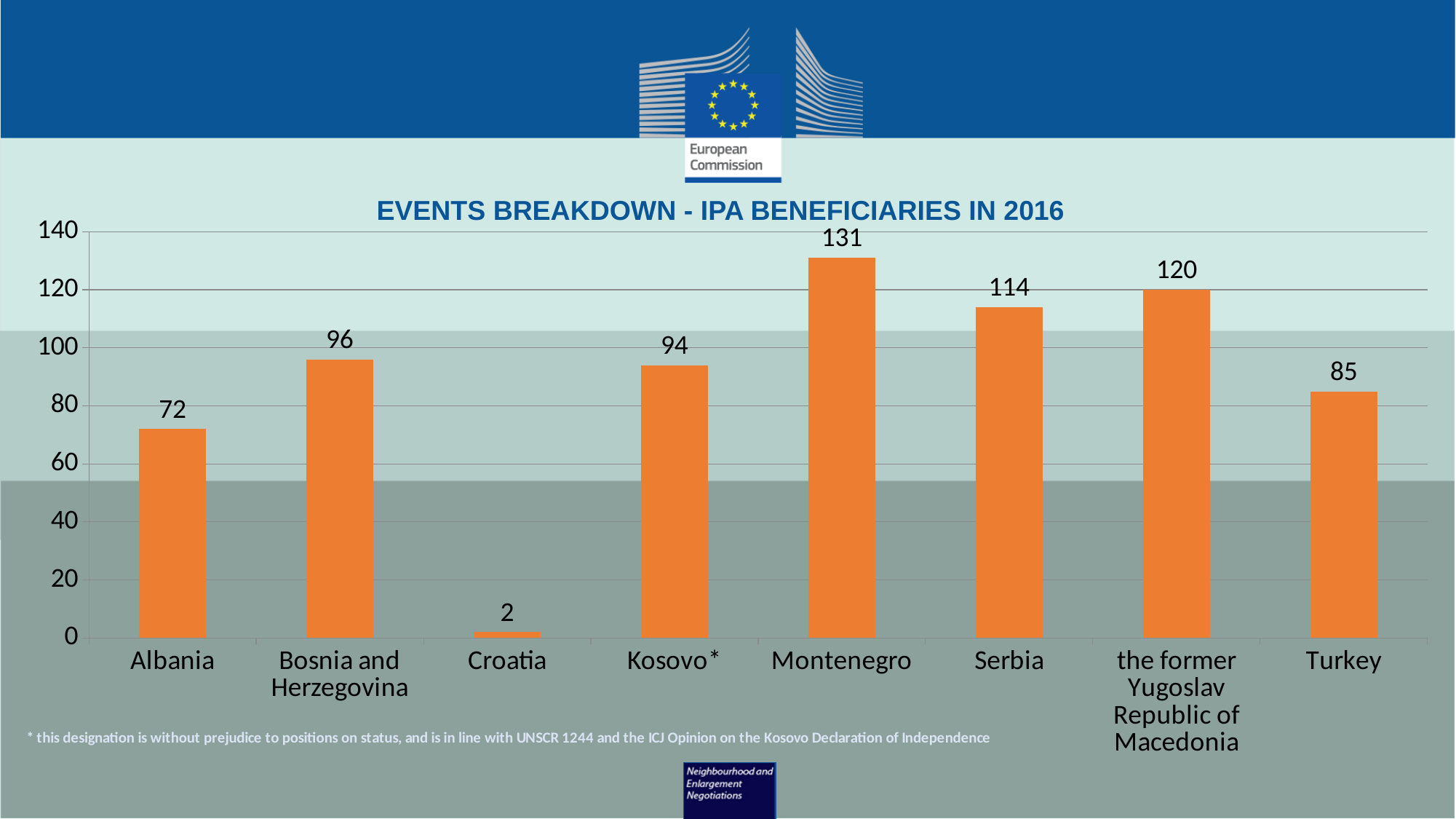
What is the title of the chart? EVENTS BREAKDOWN - IPA BENEFICIARIES IN 2016 Is the value for Turkey greater or less than 100? less What is the difference between the values for Montenegro and Serbia? 17 Which category has the highest value? Montenegro What is the value for Montenegro? 131 What is the difference between the values for Bosnia and Herzegovina and Albania? 24 What is the value for Albania? 72 Which category has the lowest value? Croatia What kind of chart is shown on the slide? bar chart What is the value for Kosovo*? 94 How many categories are shown on the x axis? 8 Which is larger, the value for Serbia or the value for the former Yugoslav Republic of Macedonia? the former Yugoslav Republic of Macedonia